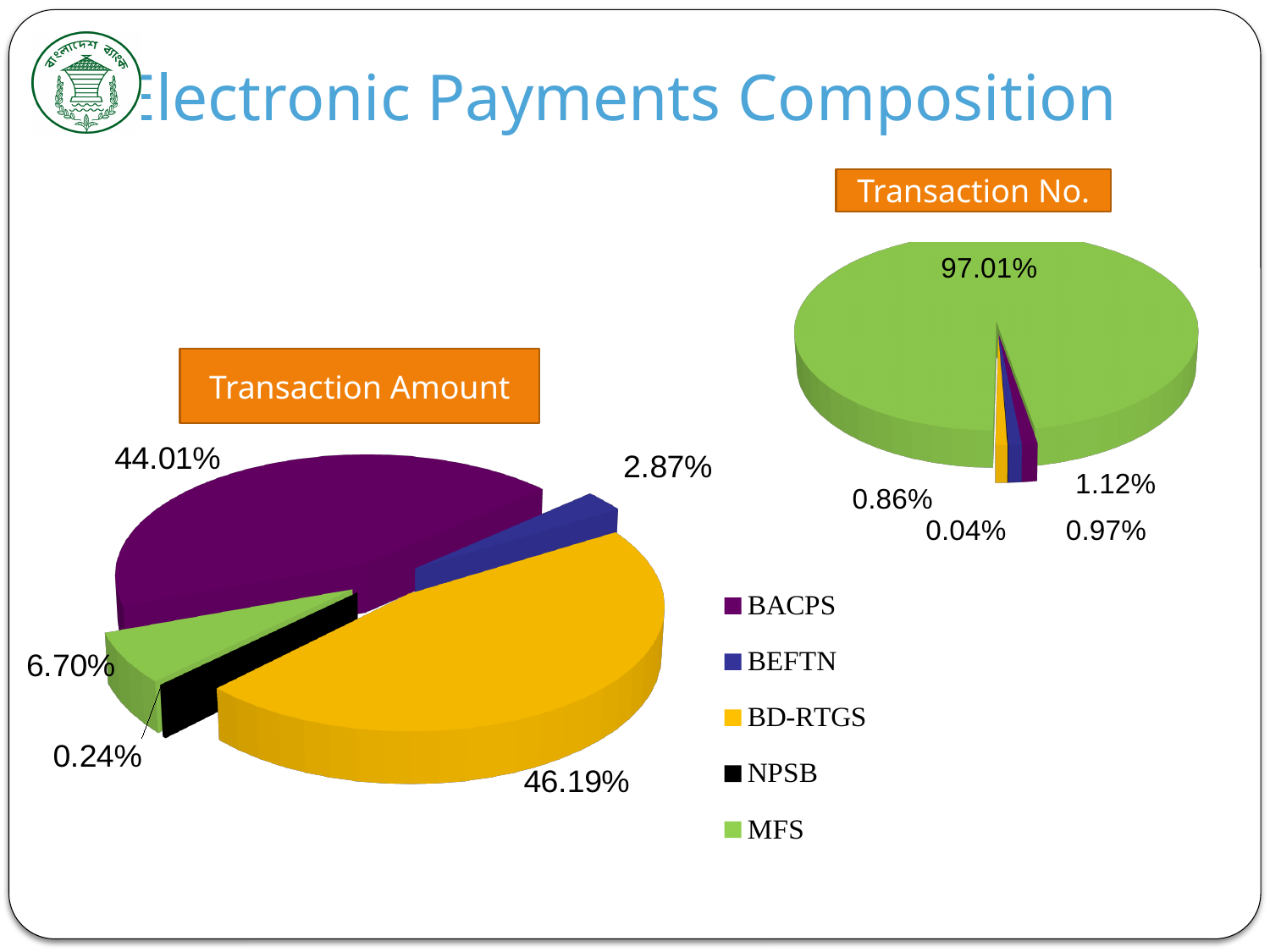
What type of chart is the Transaction Amount chart? Pie chart In the Transaction No. chart, what share does MFS have? 97.01% In the Transaction No. chart, which category has the largest share? MFS How many categories does the legend list? 5 In the Transaction Amount chart, what share does NPSB have? 0.24% In the Transaction Amount chart, which is larger, BD-RTGS or BACPS? BD-RTGS In the Transaction Amount chart, what share does BACPS have? 44.01% In the Transaction Amount chart, what share does BEFTN have? 2.87% In the Transaction Amount chart, which category has the smallest share? NPSB In the Transaction Amount chart, what share does MFS have? 6.70% In the Transaction Amount chart, what is the difference between the BD-RTGS and BACPS shares? 2.18% In the Transaction Amount chart, what share does BD-RTGS have? 46.19%